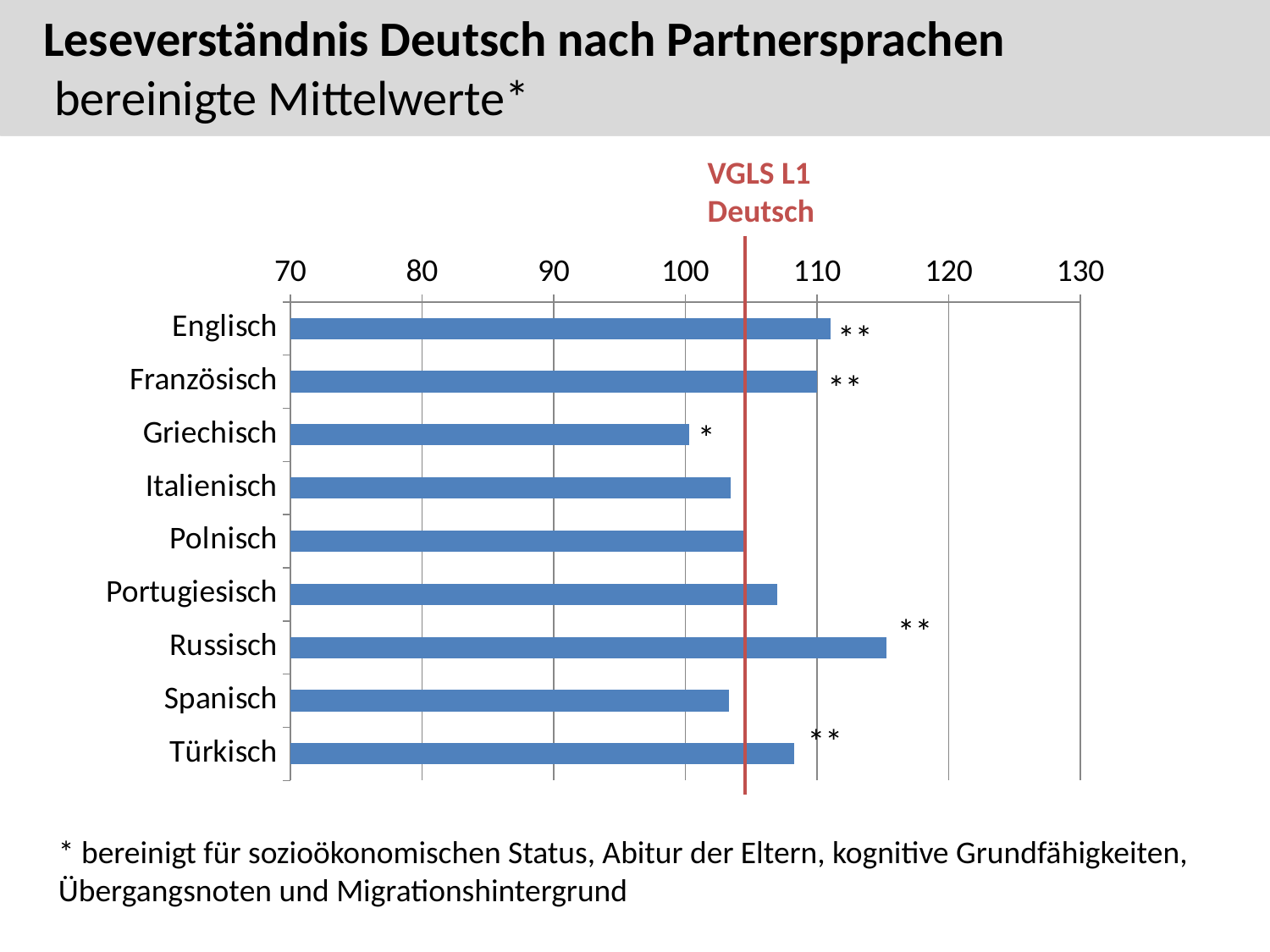
Is the value for Portugiesisch greater or less than 100? greater Which has the larger value, Russisch or Türkisch? Russisch Which partner language has the highest value in the chart? Russisch What kind of chart is shown on the slide? bar chart How many partner languages (categories) are shown in the chart? 9 Which has the larger value, Englisch or Griechisch? Englisch Is the value for Türkisch greater or less than 110? less What is the label of the red vertical reference line in the chart? VGLS L1 Deutsch Which partner language has the lowest value in the chart? Griechisch Is the value for Russisch greater or less than 110? greater